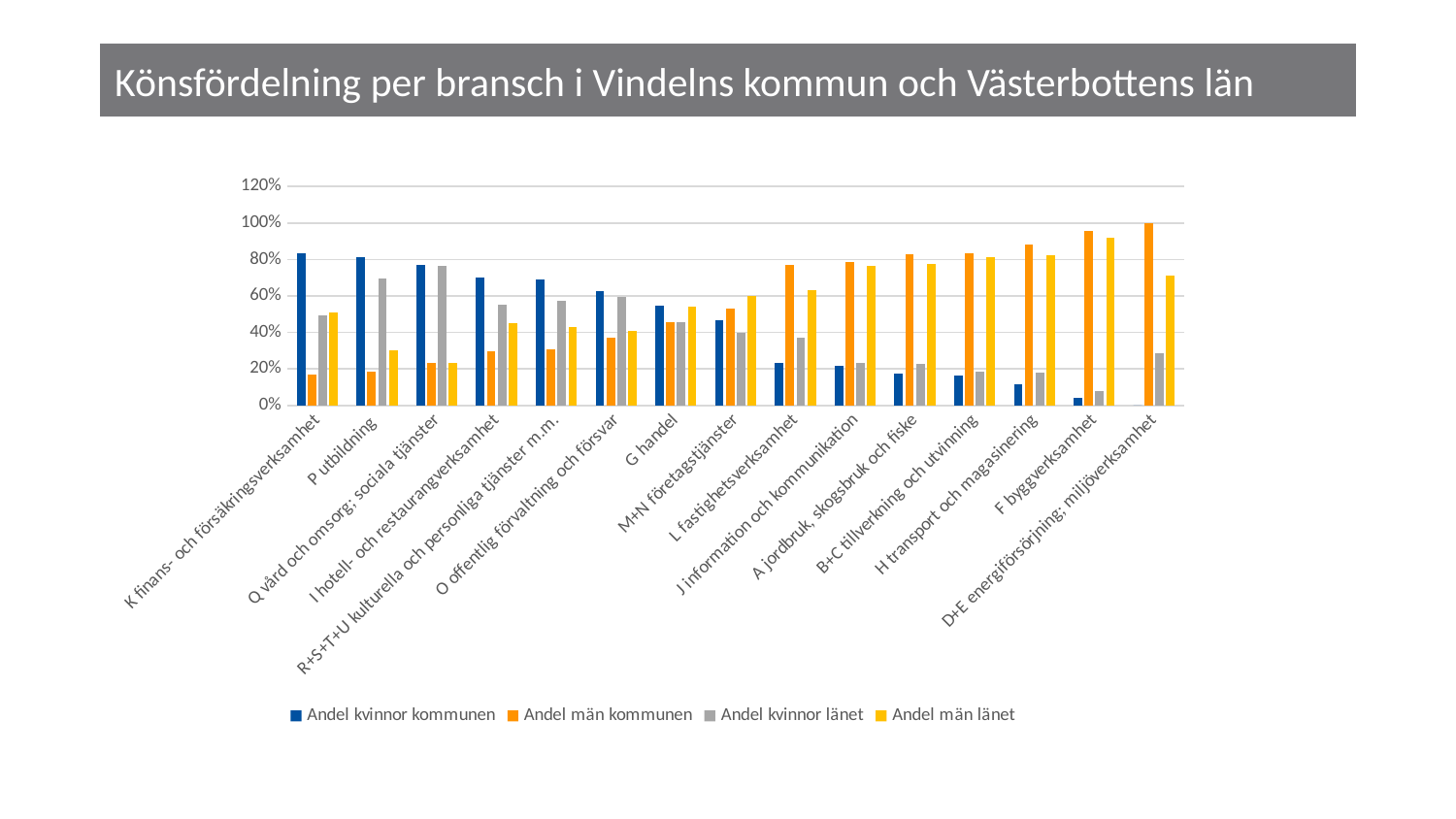
Which category has the highest value for Andel män kommunen? D+E energiförsörjning; miljöverksamhet Do the values for Andel kvinnor kommunen generally rise or fall from left to right along the x axis? Fall How many industry categories are shown on the x axis? 15 How many series does the legend list? 4 What is the value of Andel män kommunen for D+E energiförsörjning; miljöverksamhet? 100% Is the value of Andel kvinnor kommunen for K finans- och försäkringsverksamhet greater or less than 60%? greater What kind of chart is shown on the slide? Bar chart For K finans- och försäkringsverksamhet, which is larger: Andel kvinnor kommunen or Andel män kommunen? Andel kvinnor kommunen Is the value of Andel män kommunen for F byggverksamhet greater or less than 80%? greater Is the value of Andel män kommunen for K finans- och försäkringsverksamhet greater or less than 20%? less What is the title of the chart? Könsfördelning per bransch i Vindelns kommun och Västerbottens län For F byggverksamhet, which is larger: Andel män kommunen or Andel kvinnor länet? Andel män kommunen